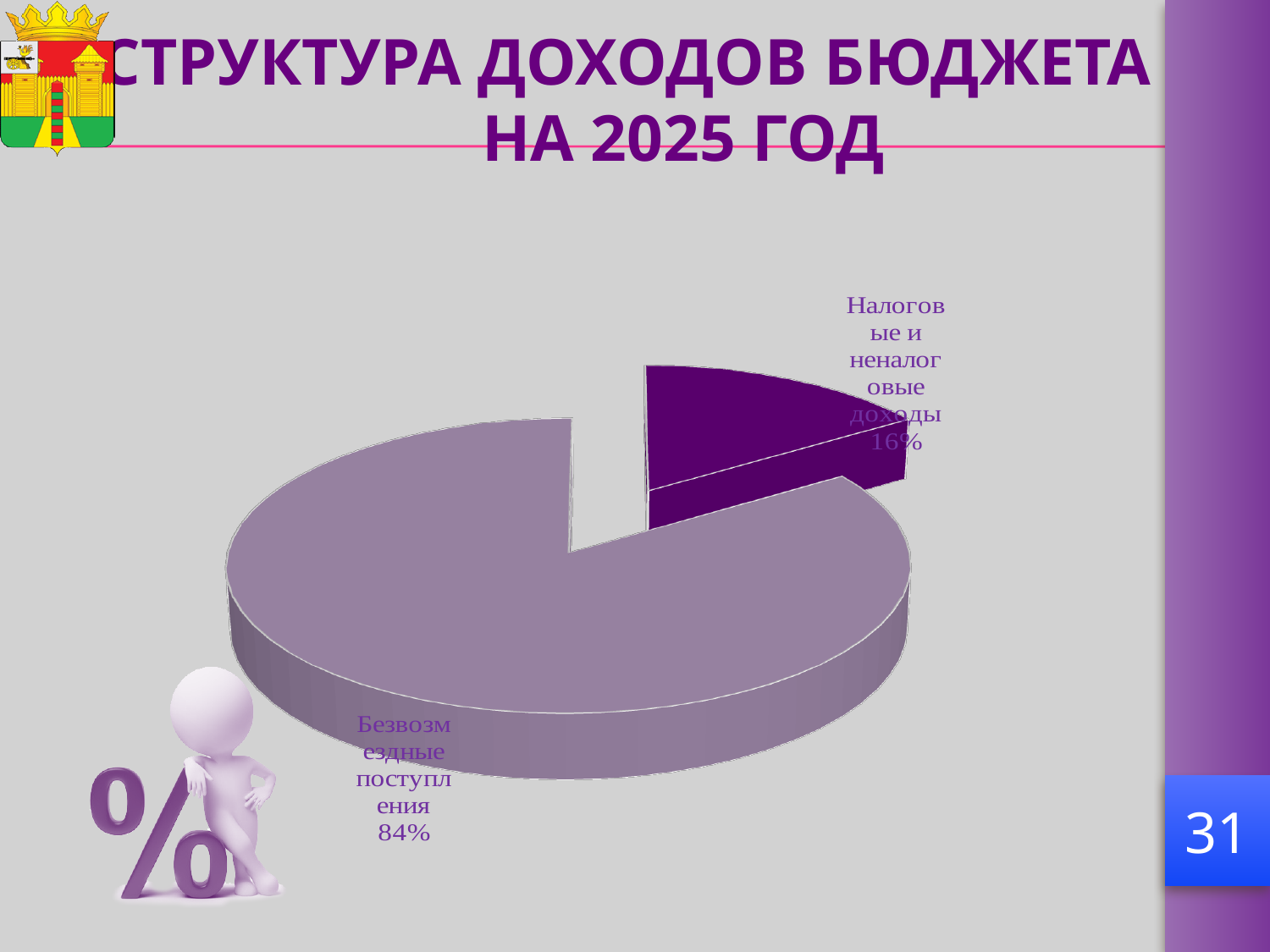
What is the total of the two pie slice percentages? 100% What is the difference in percentage points between "Безвозмездные поступления" and "Налоговые и неналоговые доходы"? 68 What is the title of the slide containing the chart? СТРУКТУРА ДОХОДОВ БЮДЖЕТА НА 2025 ГОД Which slice of the pie is the smallest? Налоговые и неналоговые доходы Which slice of the pie is the largest? Безвозмездные поступления What share of the pie does "Налоговые и неналоговые доходы" take? 16% What kind of chart is shown on the slide? Pie chart How many slices does the pie chart have? 2 What share of the pie does "Безвозмездные поступления" take? 84% Which slice is pulled out (exploded) from the pie? Налоговые и неналоговые доходы Which is larger: "Безвозмездные поступления" or "Налоговые и неналоговые доходы"? Безвозмездные поступления